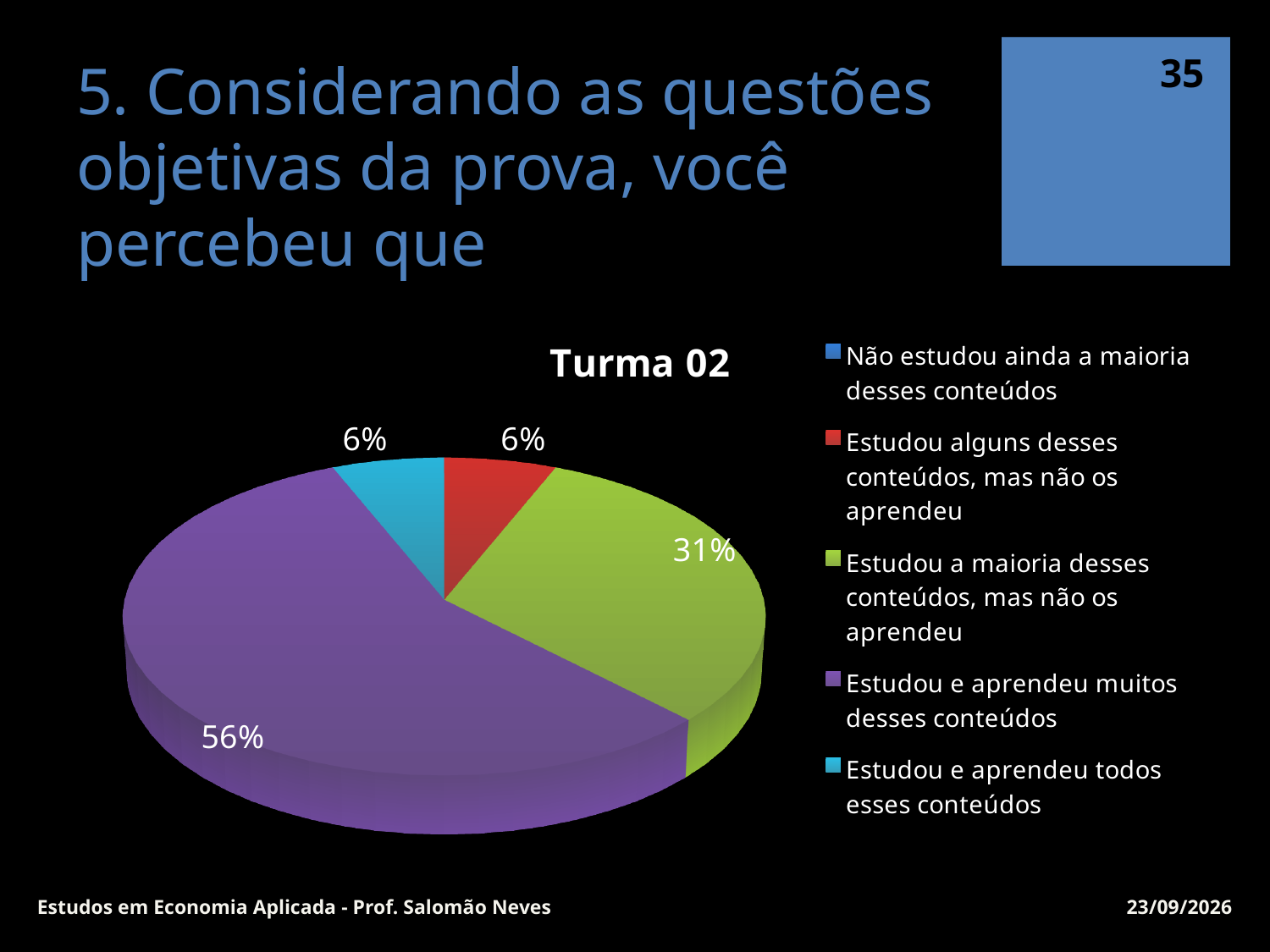
What kind of chart is shown on the slide? pie chart How many entries does the chart's legend list? 5 Which is larger: the slice for 'Estudou a maioria desses conteúdos, mas não os aprendeu' or the slice for 'Estudou alguns desses conteúdos, mas não os aprendeu'? Estudou a maioria desses conteúdos, mas não os aprendeu What colour is the slice for 'Estudou e aprendeu muitos desses conteúdos'? purple What share of the pie is 'Estudou e aprendeu todos esses conteúdos'? 6% What share of the pie is 'Estudou a maioria desses conteúdos, mas não os aprendeu'? 31% What share of the pie is 'Estudou e aprendeu muitos desses conteúdos'? 56% What is the title of the chart? Turma 02 Is the share for 'Estudou e aprendeu muitos desses conteúdos' greater or less than 50%? greater Which category has the largest slice of the pie? Estudou e aprendeu muitos desses conteúdos What is the difference in percentage points between the 'Estudou e aprendeu muitos desses conteúdos' slice and the 'Estudou a maioria desses conteúdos, mas não os aprendeu' slice? 25